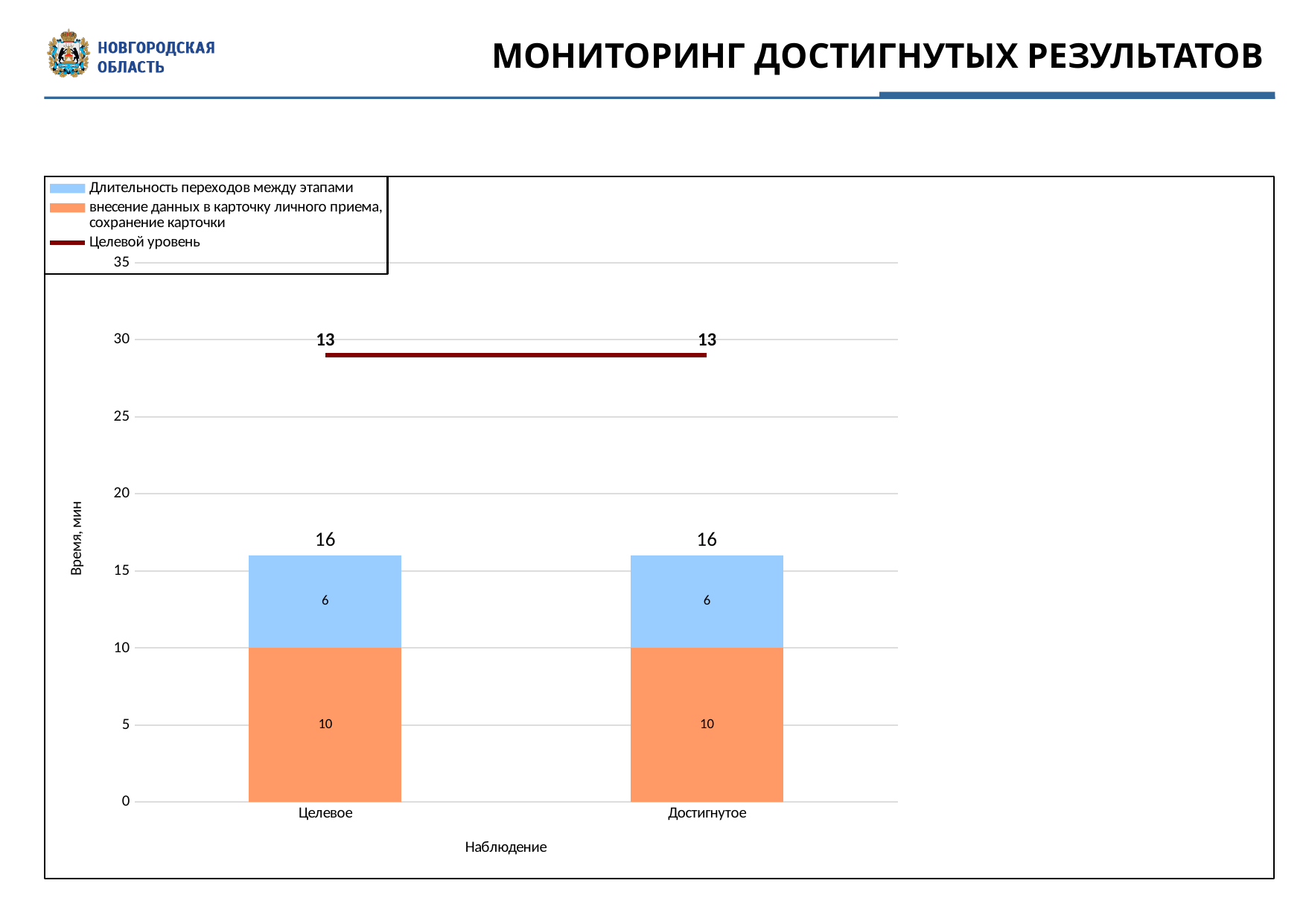
What is the label of the y axis of the chart? Время, мин How many categories are shown on the x axis of the chart? 2 What kind of chart is shown on the slide? stacked bar chart with a line (combination bar and line chart) What is the label of the x axis of the chart? Наблюдение How many series does the chart legend list? 3 What is the value of 'внесение данных в карточку личного приема, сохранение карточки' for 'Целевое'? 10 Which is larger for 'Достигнутое': the 'внесение данных в карточку личного приема, сохранение карточки' segment or the 'Длительность переходов между этапами' segment? внесение данных в карточку личного приема, сохранение карточки What is the value of 'Длительность переходов между этапами' for 'Достигнутое'? 6 What is the difference between the 'внесение данных в карточку личного приема, сохранение карточки' value and the 'Длительность переходов между этапами' value for 'Целевое'? 4 What is the total of the stacked bar for 'Целевое'? 16 What is the total of the stacked bar for 'Достигнутое'? 16 What is the labelled value of the 'Целевой уровень' line at 'Достигнутое'? 13